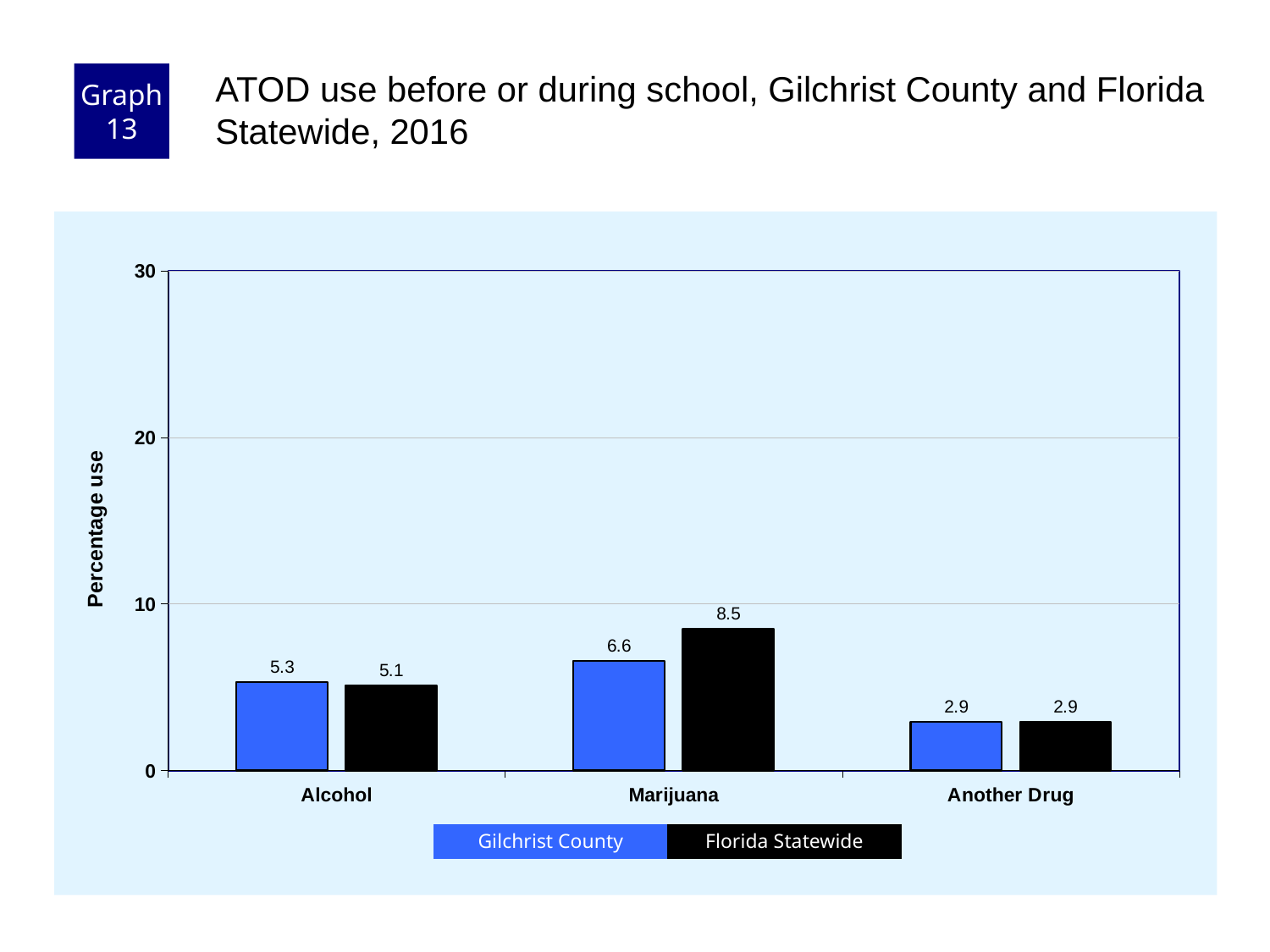
What is the difference between the Florida Statewide and Gilchrist County values for Marijuana? 1.9 Is the Florida Statewide value for Marijuana greater or less than 10? less What is the Gilchrist County value for Marijuana? 6.6 What kind of chart is shown on the slide? bar chart How many categories are shown on the x axis? 3 How many series does the legend list? 2 What is the Florida Statewide value for Alcohol? 5.1 For Alcohol, which is larger: the Gilchrist County value or the Florida Statewide value? Gilchrist County Which category has the lowest Gilchrist County value? Another Drug Which category has the highest Florida Statewide value? Marijuana What is the label of the y axis? Percentage use What is the Florida Statewide value for Another Drug? 2.9